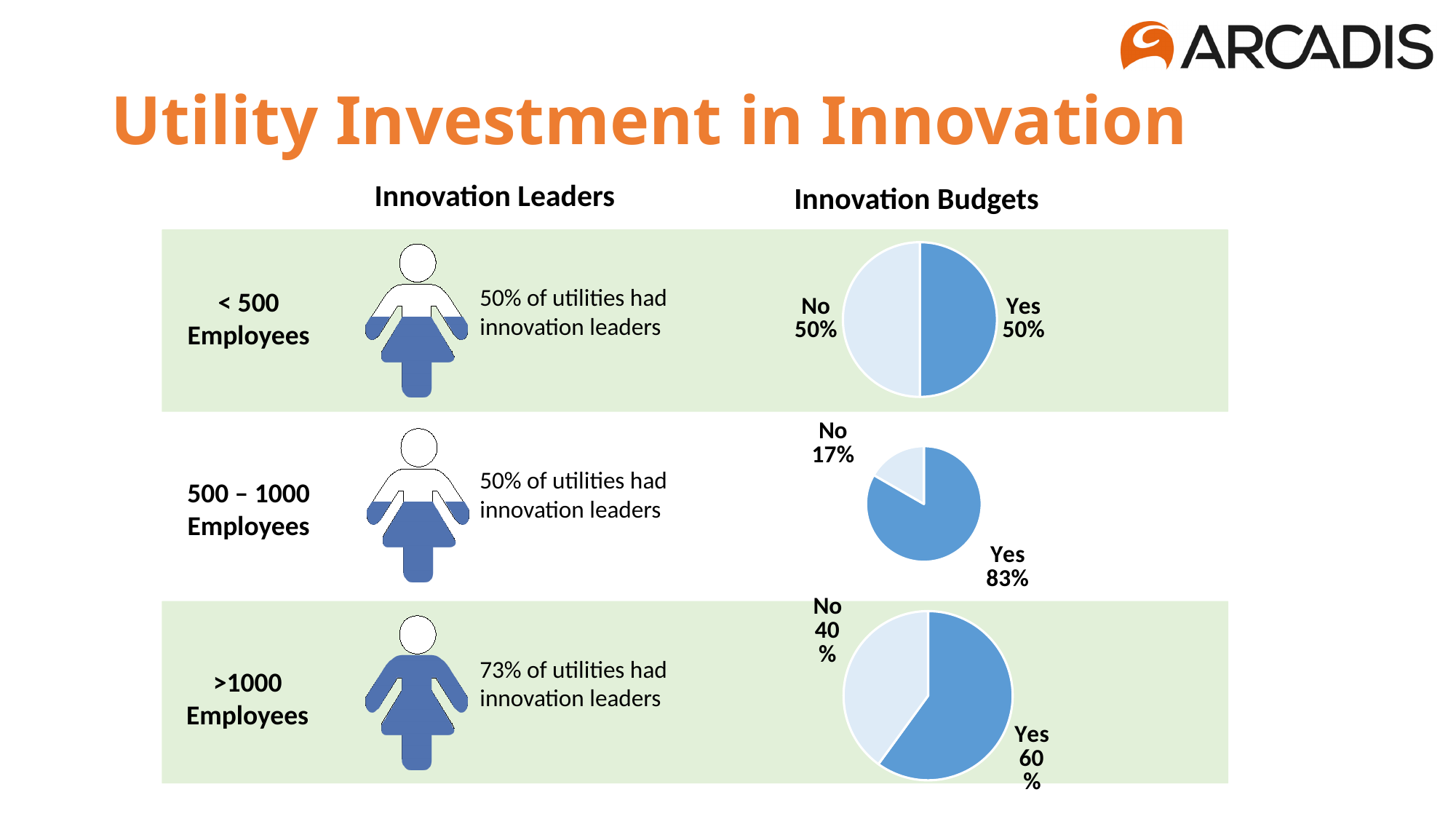
How many pie charts are shown in the Innovation Budgets column? 3 In the Innovation Budgets pie chart for the >1000 Employees row, what is the difference between the Yes and No shares? 20% Across the three Innovation Budgets pie charts, which employee group has the highest Yes share? 500 – 1000 Employees In the Innovation Budgets pie chart for the 500 – 1000 Employees row, what is the difference between the Yes and No shares? 66% In the Innovation Budgets pie chart for the 500 – 1000 Employees row, what share of utilities answered No? 17% In the Innovation Budgets pie chart for the 500 – 1000 Employees row, what share of utilities answered Yes? 83% What kind of chart is used in the Innovation Budgets column for each employee group? Pie chart In the Innovation Budgets pie chart for the >1000 Employees row, what share of utilities answered Yes? 60% In the Innovation Budgets pie chart for the >1000 Employees row, what share of utilities answered No? 40% In the Innovation Budgets pie chart for the < 500 Employees row, what share of utilities answered Yes? 50% How many slices does each Innovation Budgets pie chart have? 2 In the Innovation Budgets pie chart for the 500 – 1000 Employees row, which slice is larger, Yes or No? Yes